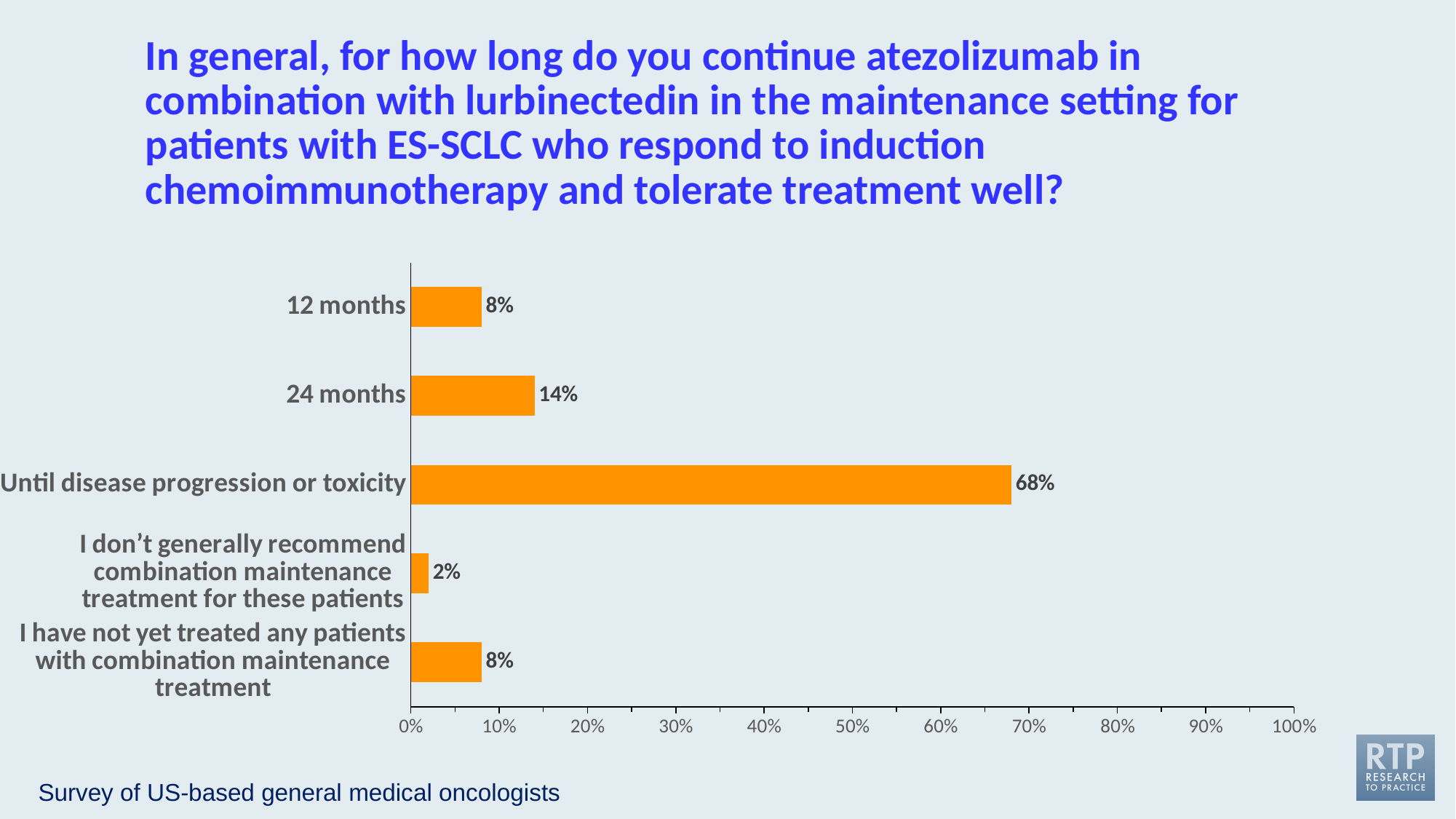
What is the difference in percentage points between 'Until disease progression or toxicity' and '24 months'? 54 Is the value for 'Until disease progression or toxicity' greater or less than 60%? greater How many response categories are shown in the chart? 5 What percentage of respondents continue atezolizumab with lurbinectedin until disease progression or toxicity? 68% Which response option has the highest percentage? Until disease progression or toxicity What percentage of respondents said they don't generally recommend combination maintenance treatment for these patients? 2% Which response option has the lowest percentage? I don't generally recommend combination maintenance treatment for these patients What percentage of respondents continue treatment for 24 months? 14% What type of chart is shown on the slide? Bar chart What colour are the bars in the chart? Orange Which has a larger percentage, '24 months' or '12 months'? 24 months What percentage of respondents continue treatment for 12 months? 8%